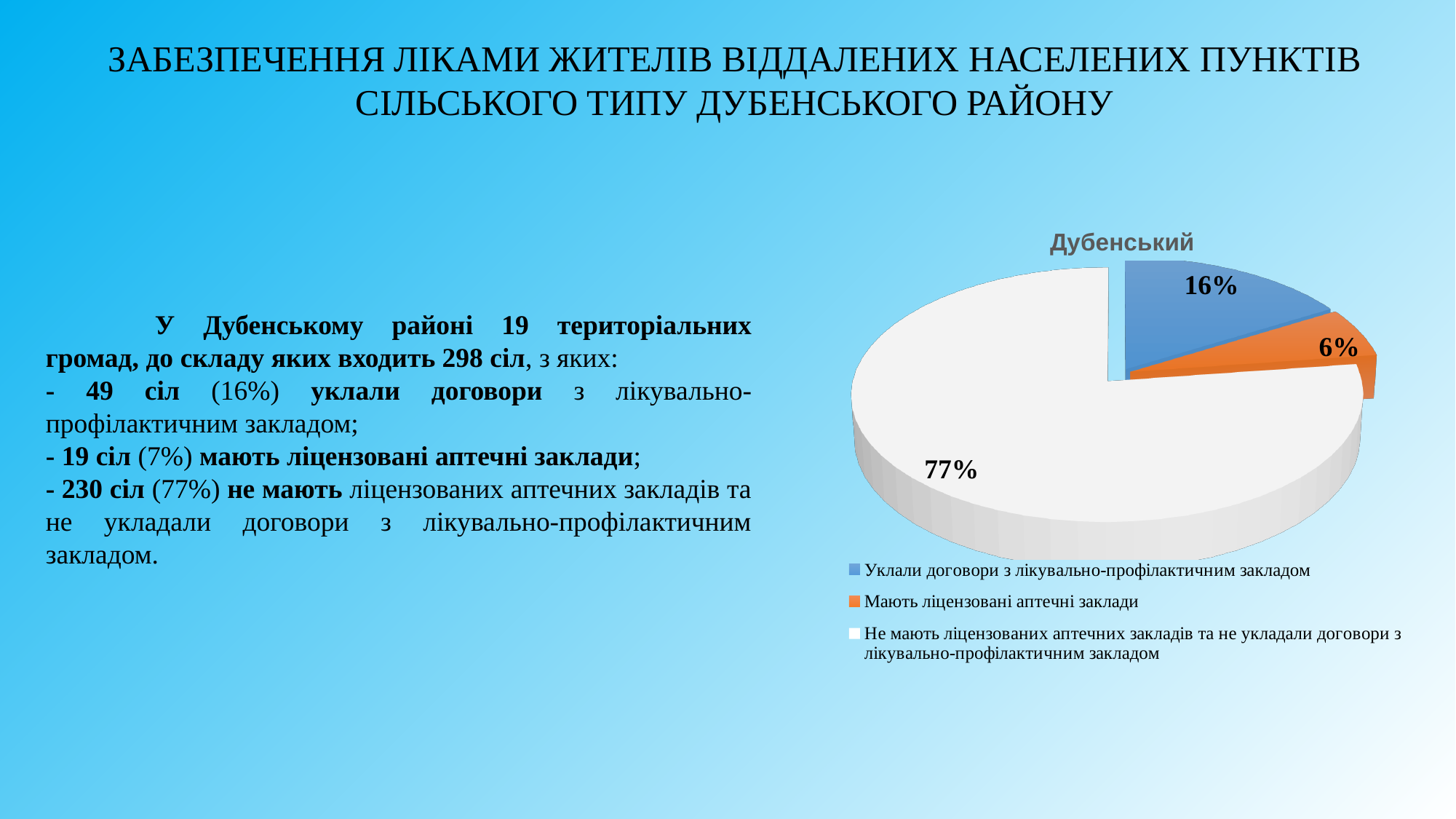
What is the title of the chart? Дубенський What colour is the slice for "Мають ліцензовані аптечні заклади"? orange What type of chart is shown on the slide? pie chart Which slice is larger: "Уклали договори з лікувально-профілактичним закладом" or "Мають ліцензовані аптечні заклади"? Уклали договори з лікувально-профілактичним закладом What is the difference in percentage points between the "Уклали договори з лікувально-профілактичним закладом" slice and the "Мають ліцензовані аптечні заклади" slice? 10 What percentage is shown for the slice "Мають ліцензовані аптечні заклади"? 6% How many slices does the pie chart have? 3 How many entries does the legend list? 3 What percentage is shown for the slice "Уклали договори з лікувально-профілактичним закладом"? 16% Which category has the smallest slice of the pie? Мають ліцензовані аптечні заклади What percentage is shown for the slice "Не мають ліцензованих аптечних закладів та не укладали договори з лікувально-профілактичним закладом"? 77% Which category has the largest slice of the pie? Не мають ліцензованих аптечних закладів та не укладали договори з лікувально-профілактичним закладом